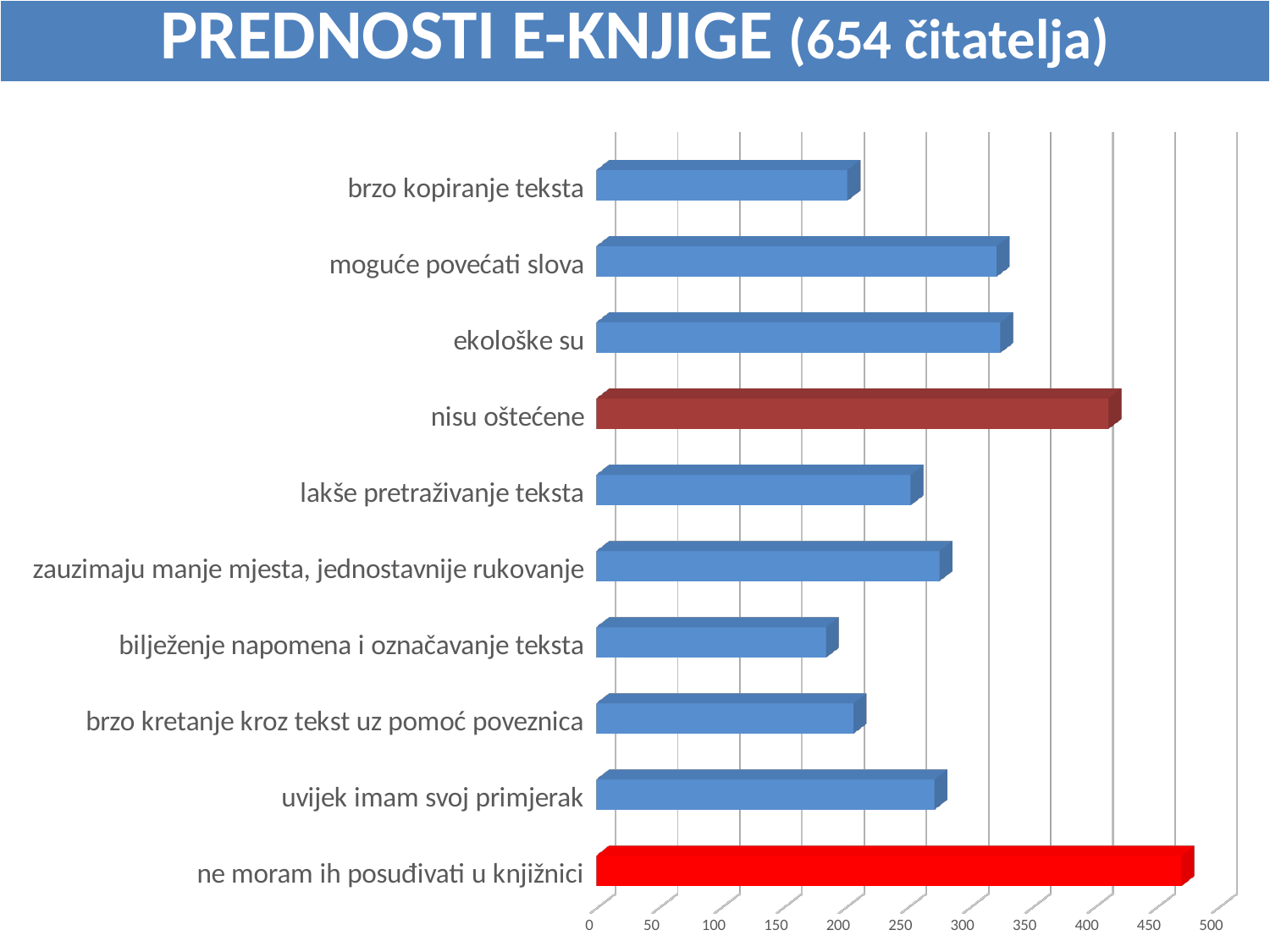
Is the value for 'moguće povećati slova' greater or less than 300? greater Is the value for 'nisu oštećene' greater or less than 350? greater Which has a larger value: 'nisu oštećene' or 'ekološke su'? nisu oštećene What colour is the bar for 'ne moram ih posuđivati u knjižnici'? red What kind of chart is shown on the slide? bar chart Is the value for 'ne moram ih posuđivati u knjižnici' greater or less than 450? greater Which has a larger value: 'moguće povećati slova' or 'brzo kopiranje teksta'? moguće povećati slova What is the title of the chart? PREDNOSTI E-KNJIGE (654 čitatelja) How many categories are shown in the chart? 10 Which category has the highest value? ne moram ih posuđivati u knjižnici